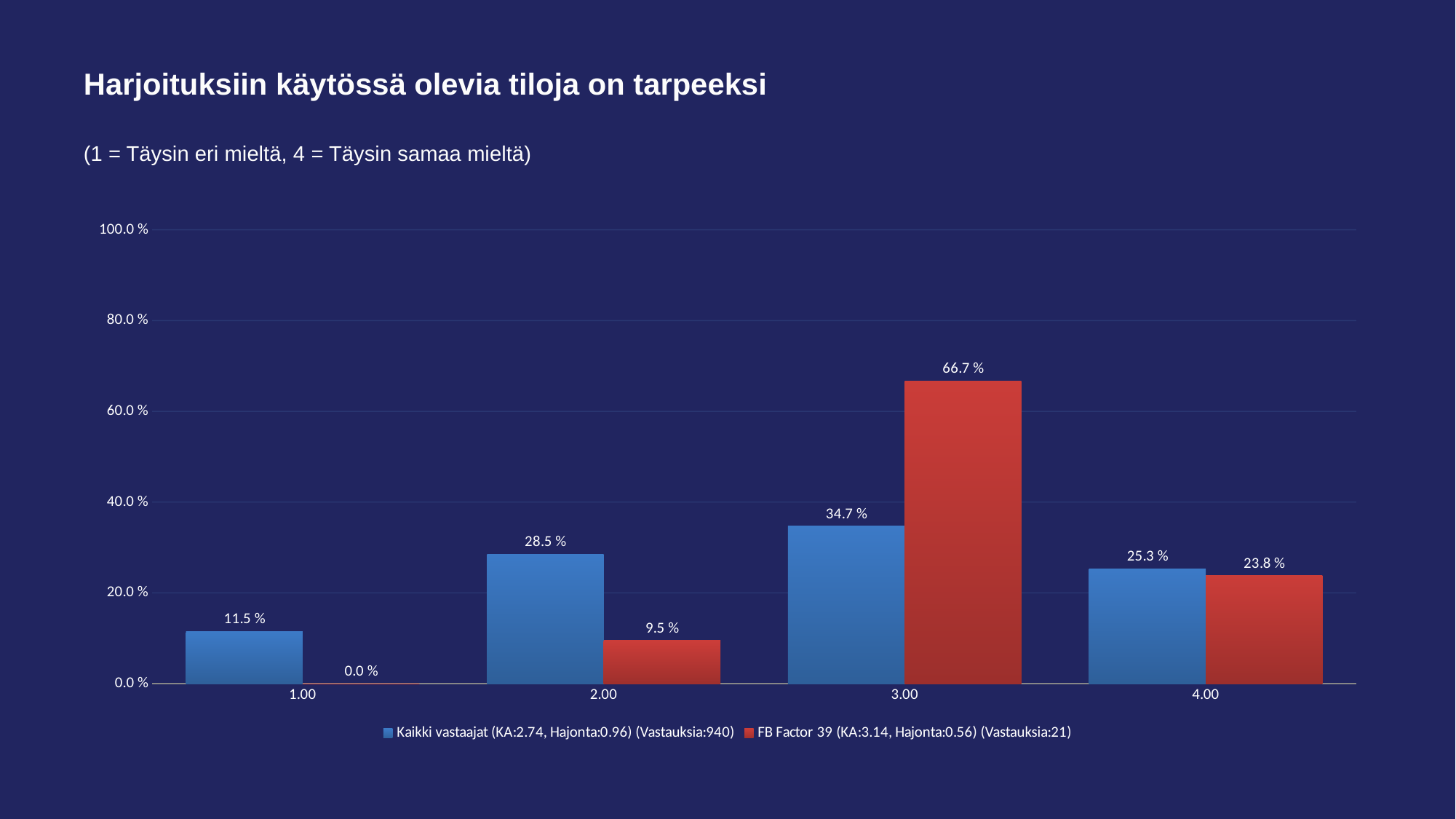
What kind of chart is shown on the slide? Bar chart What is the value for Kaikki vastaajat at 4.00? 25.3 % At 2.00, which series has the larger value, Kaikki vastaajat or FB Factor 39? Kaikki vastaajat What is the value for FB Factor 39 at 3.00? 66.7 % What is the value for Kaikki vastaajat at 1.00? 11.5 % What is the value for FB Factor 39 at 2.00? 9.5 % Which category has the highest value for FB Factor 39? 3.00 Is the value for FB Factor 39 at 3.00 greater or less than 60.0 %? greater Which category has the lowest value for Kaikki vastaajat? 1.00 What is the difference between the FB Factor 39 and Kaikki vastaajat values at 3.00? 32.0 % How many series does the legend list? 2 How many categories are shown on the x axis? 4